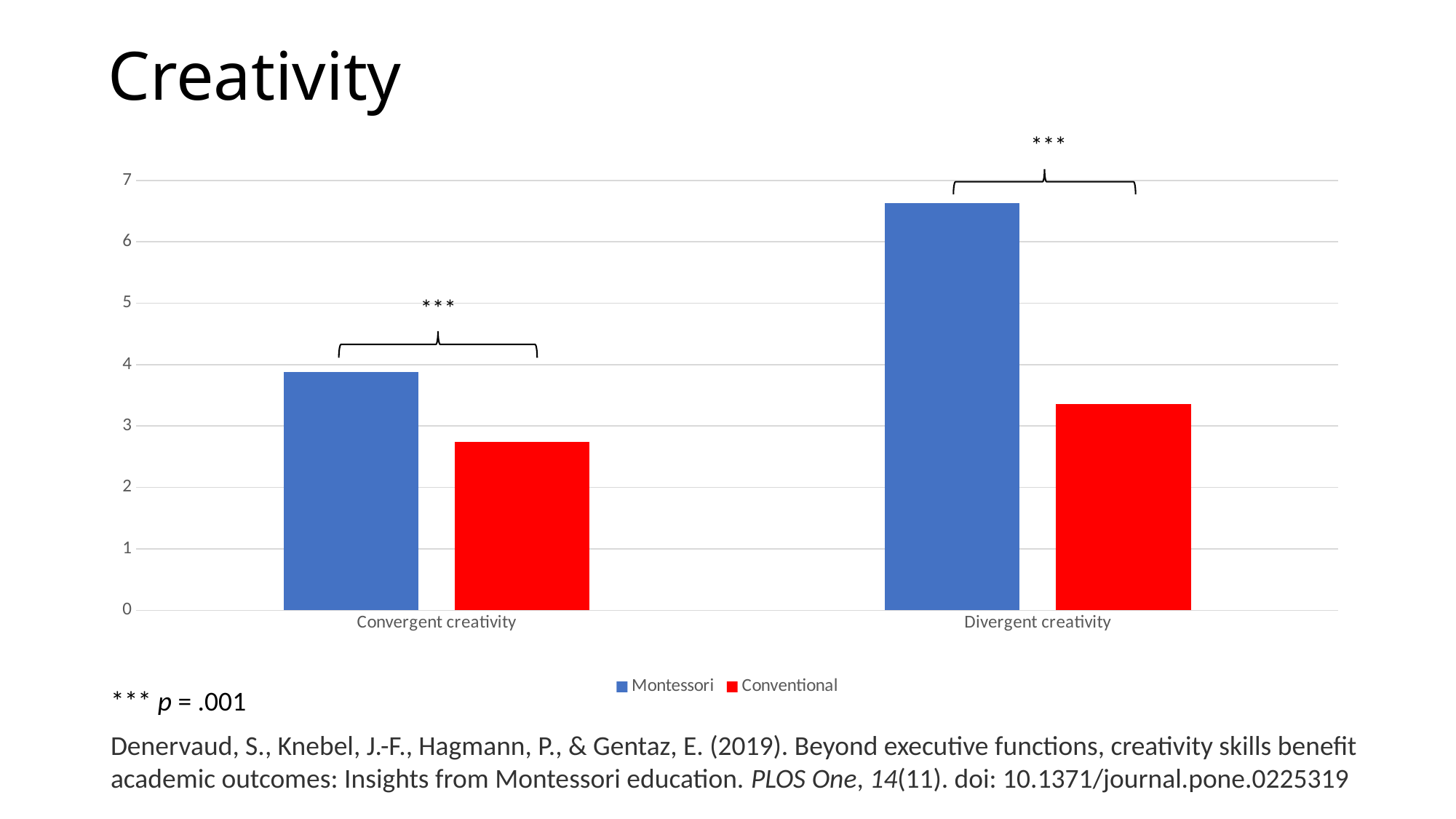
How many series does the legend list? 2 What kind of chart is shown on the slide? Bar chart How many categories are shown on the x axis? 2 Which bar is the shortest in the chart? Conventional, Convergent creativity For Convergent creativity, which group has the higher value, Montessori or Conventional? Montessori Is the Montessori value for Divergent creativity greater or less than 6? greater Which series is shown in blue? Montessori Is the Conventional value for Divergent creativity greater or less than 4? less Which series is shown in red? Conventional For Divergent creativity, which group has the higher value, Montessori or Conventional? Montessori Which bar is the tallest in the chart? Montessori, Divergent creativity Is the Conventional value for Convergent creativity greater or less than 3? less